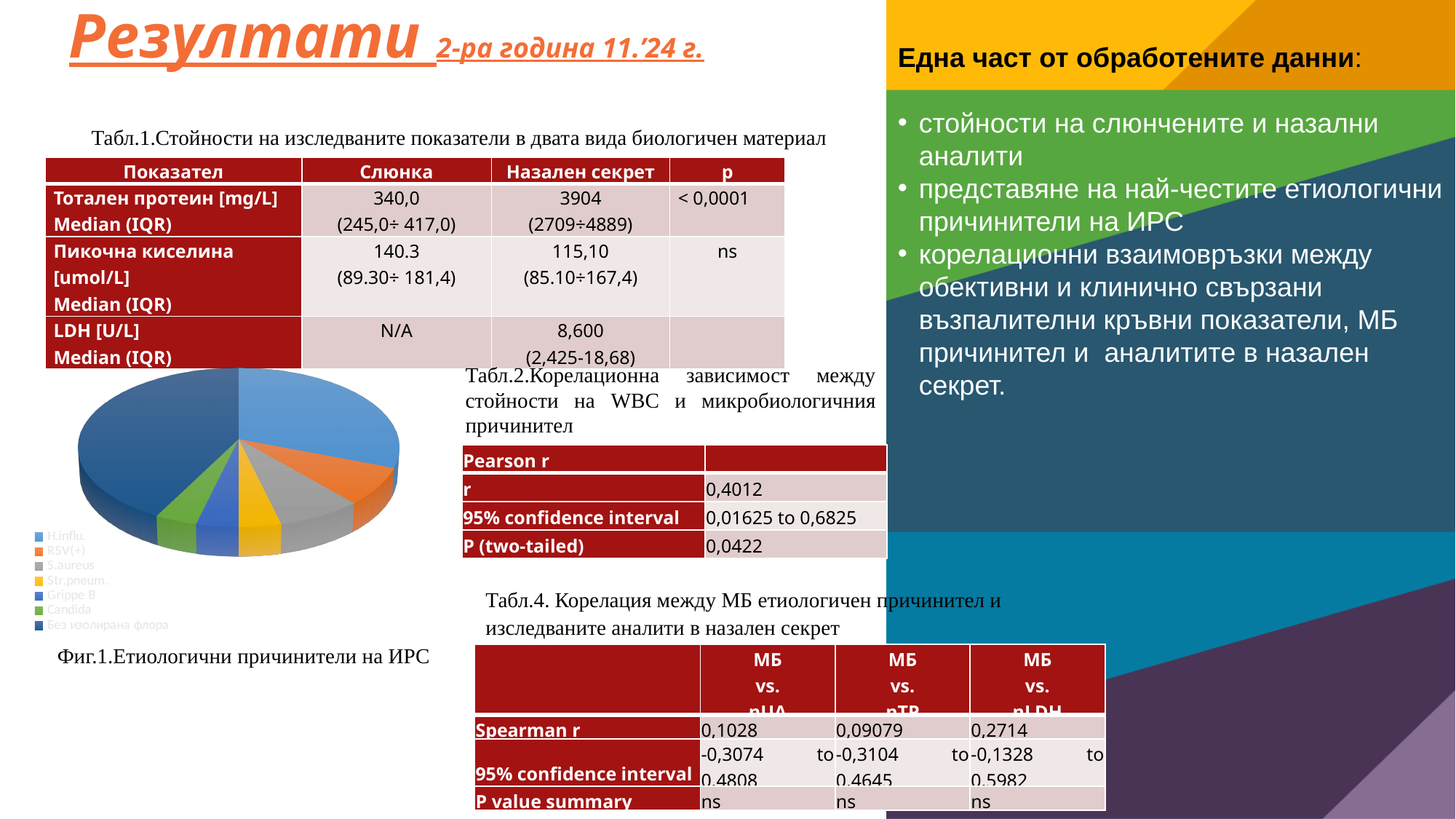
What is the caption of the pie chart on the slide? Фиг.1.Етиологични причинители на ИРС What kind of chart is shown in Фиг.1? pie chart In the pie chart in Фиг.1, which slice is larger: H.influ. or Candida? H.influ. What colour represents Candida in the pie chart in Фиг.1? green In the pie chart in Фиг.1, which slice is larger: Без изолирана флора or S.aureus? Без изолирана флора How many categories does the legend of the pie chart in Фиг.1 list? 7 Which category has the largest slice in the pie chart in Фиг.1? Без изолирана флора In the pie chart in Фиг.1, which slice is larger: Без изолирана флора or H.influ.? Без изолирана флора